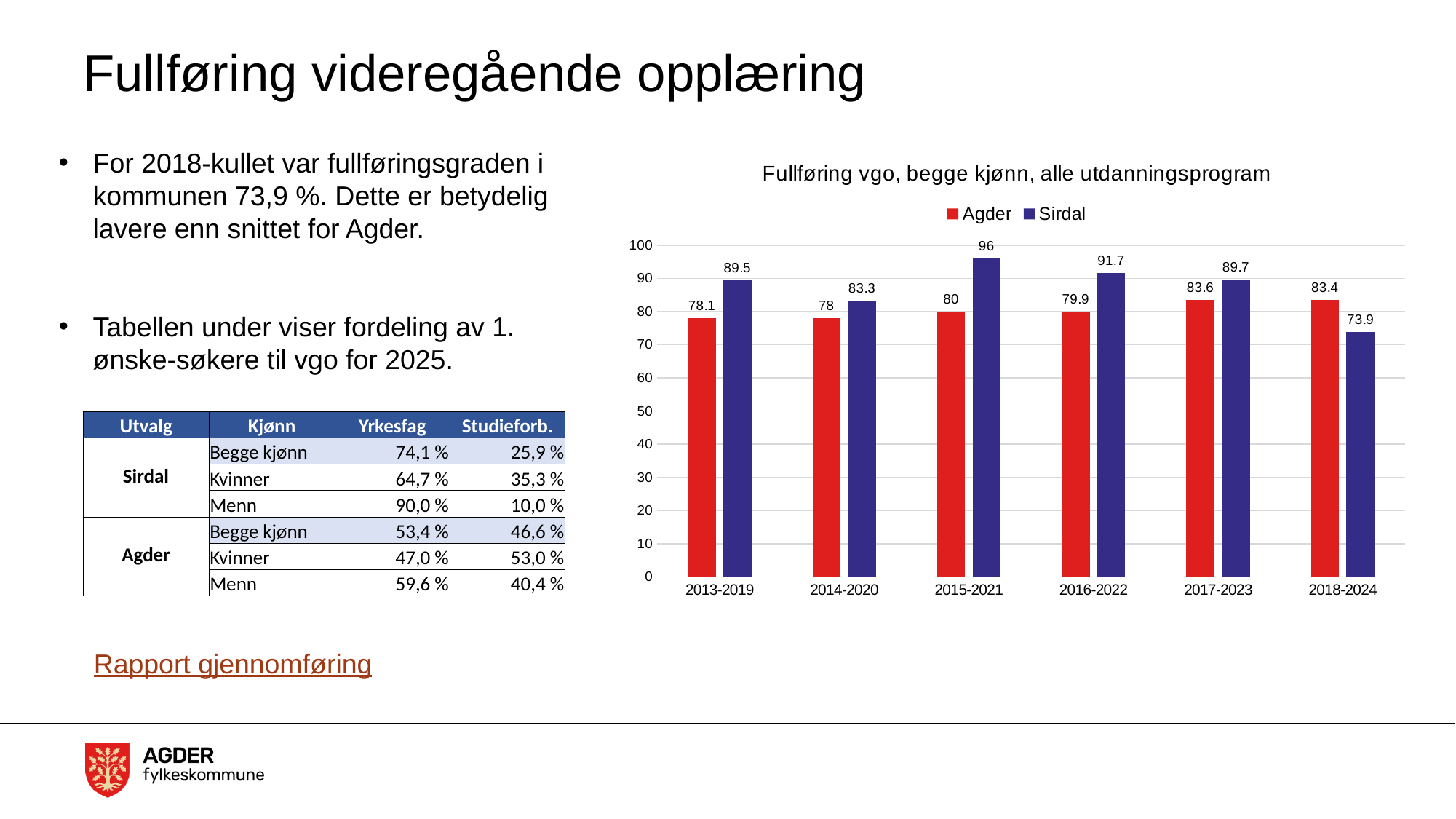
What is the difference between Sirdal and Agder in 2016-2022? 11.8 Which period has the lowest value for Agder? 2014-2020 What is the value for Agder in 2018-2024? 83.4 How many series does the legend list? 2 What is the value for Sirdal in 2015-2021? 96 What is the value for Sirdal in 2018-2024? 73.9 Is the value for Sirdal in 2015-2021 greater or less than 90? greater Which period has the highest value for Sirdal? 2015-2021 What is the title of the chart? Fullføring vgo, begge kjønn, alle utdanningsprogram Which is larger in 2018-2024, Agder or Sirdal? Agder How many periods are shown on the x axis? 6 What kind of chart is shown? bar chart